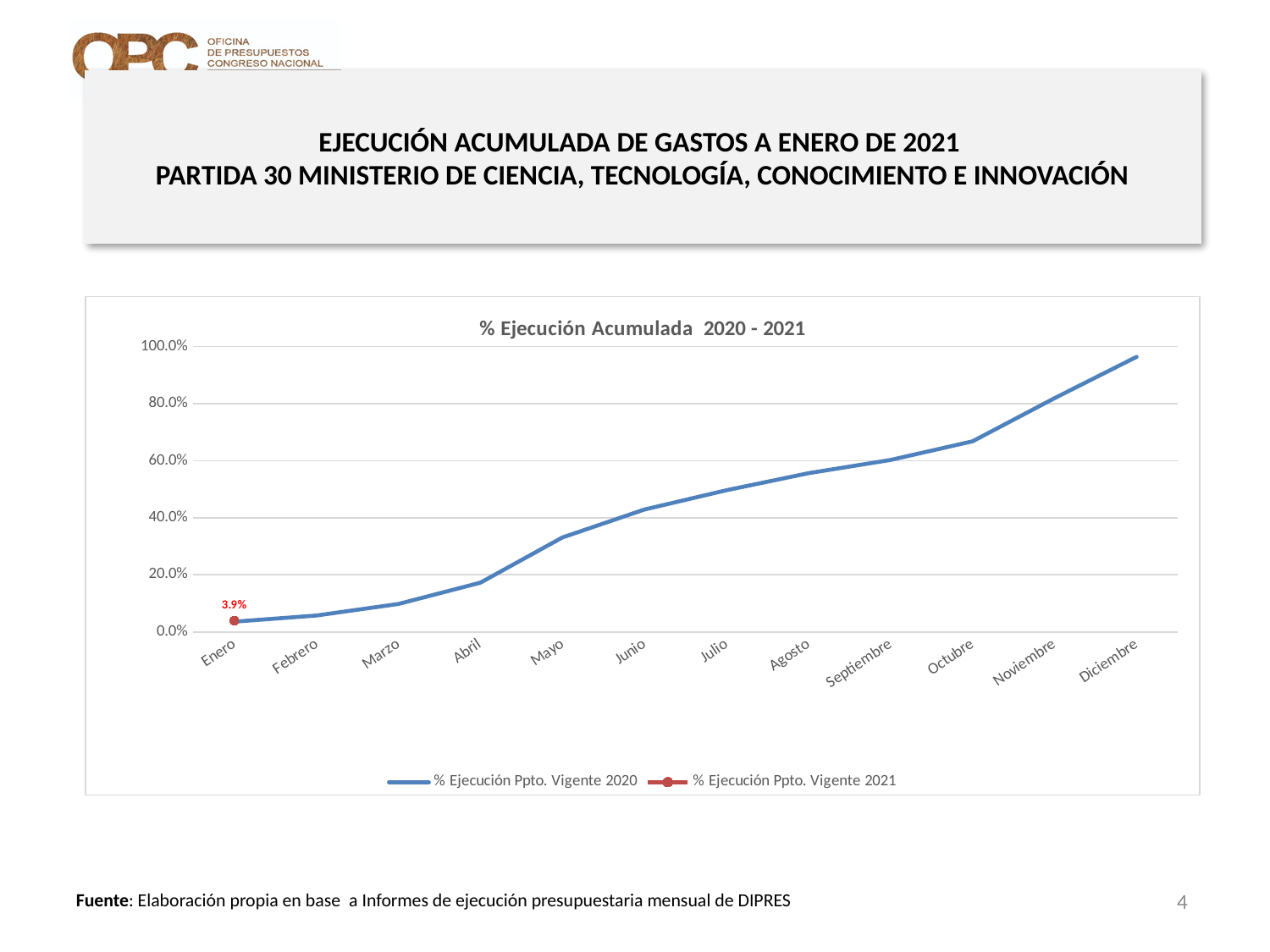
In which month does the % Ejecución Ppto. Vigente 2020 line reach its highest value? Diciembre Is the value of % Ejecución Ppto. Vigente 2020 for Octubre greater or less than 60.0%? greater How many months are shown on the x axis of the chart? 12 What kind of chart is shown on the slide? line chart Which series is drawn with a red marker in the chart? % Ejecución Ppto. Vigente 2021 Is the value of % Ejecución Ppto. Vigente 2020 for Mayo greater or less than 40.0%? less Does the % Ejecución Ppto. Vigente 2020 line rise or fall from Enero to Diciembre? rise What is the value of % Ejecución Ppto. Vigente 2021 for Enero? 3.9% How many series does the chart legend list? 2 Is the value of % Ejecución Ppto. Vigente 2020 for Diciembre greater or less than 80.0%? greater In which month is the % Ejecución Ppto. Vigente 2020 line at its lowest value? Enero What is the title of the chart? % Ejecución Acumulada 2020 - 2021